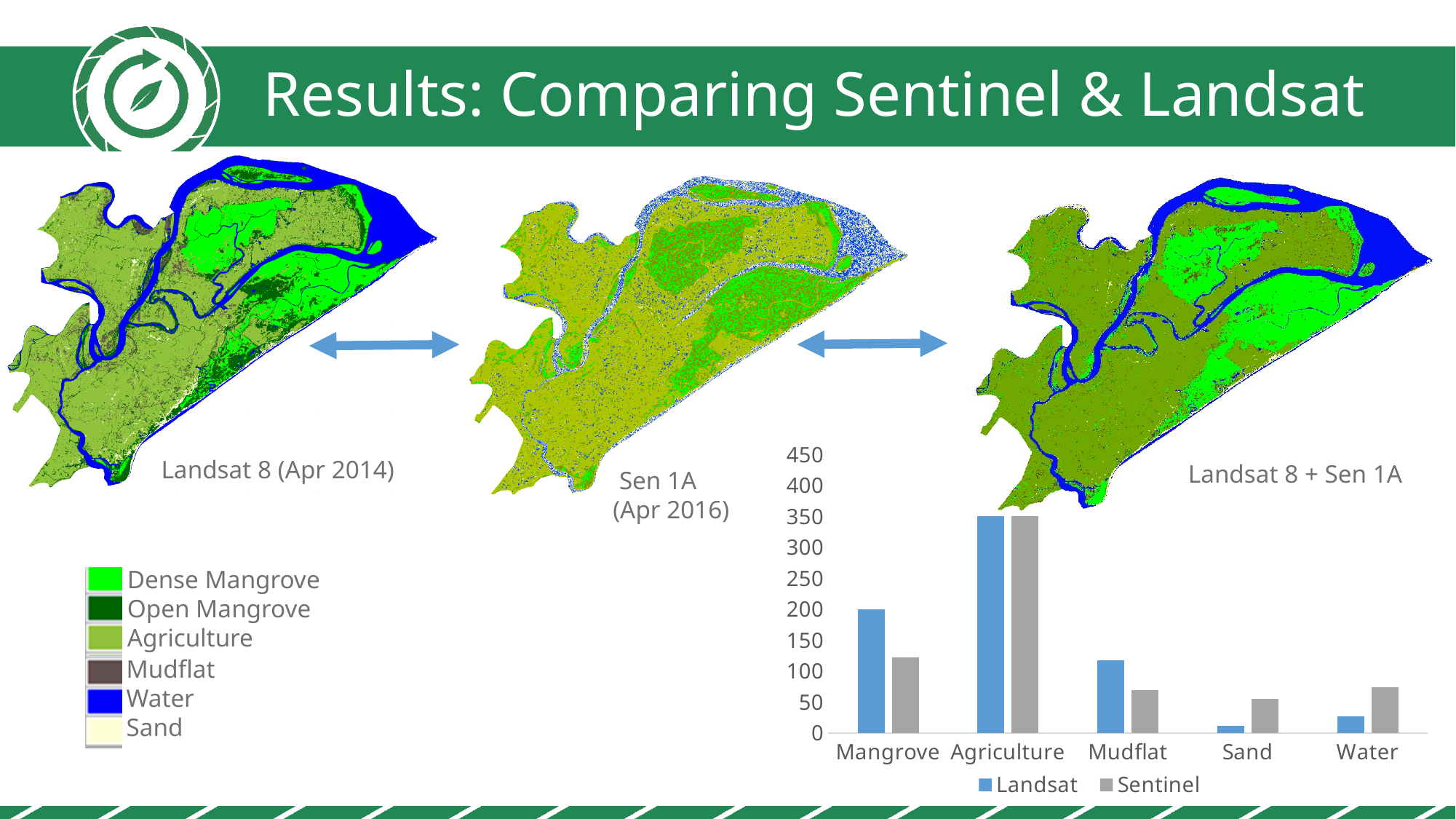
Is the Landsat value for Mangrove greater or less than 150? greater Which category has the highest Landsat value in the bar chart? Agriculture Which category has the highest Sentinel value in the bar chart? Agriculture Is the Sentinel value for Water greater or less than 50? greater For Mangrove, which series has the larger value, Landsat or Sentinel? Landsat What kind of chart is shown at the bottom right of the slide? bar chart Which category has the lowest Landsat value in the bar chart? Sand For Sand, which series has the larger value, Landsat or Sentinel? Sentinel How many categories are shown on the x axis of the bar chart? 5 Is the Sentinel value for Mudflat greater or less than 100? less How many series does the bar chart's legend list? 2 What colour are the Landsat bars in the bar chart? blue